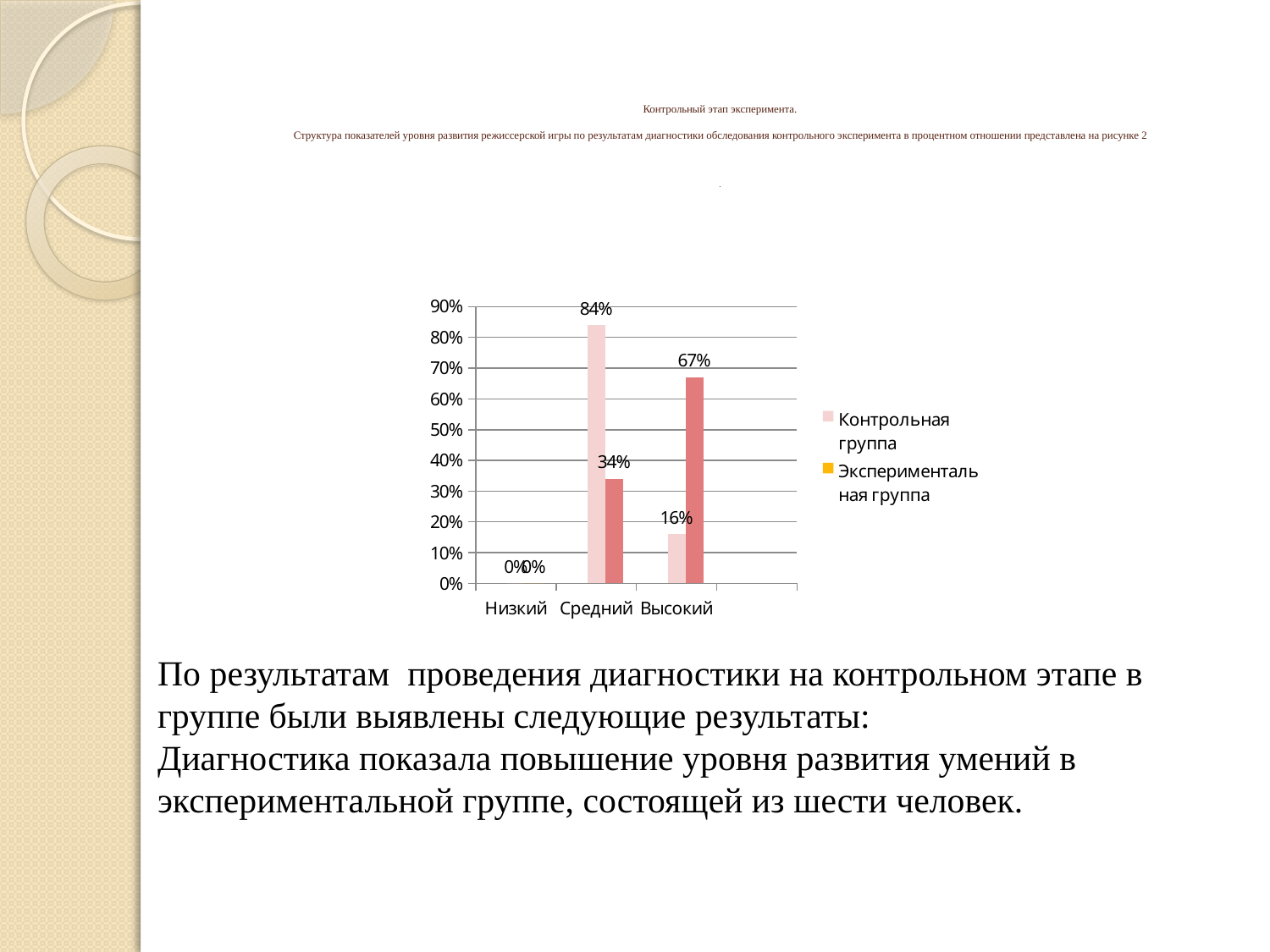
In which category does the Экспериментальная группа series have its highest value? Высокий What is the value for the Экспериментальная группа series in the Высокий category? 67% What is the value for the Экспериментальная группа series in the Средний category? 34% What is the value for the Контрольная группа series in the Высокий category? 16% What is the value for the Контрольная группа series in the Низкий category? 0% In which category does the Контрольная группа series have its highest value? Средний In the Высокий category, which series has the larger value: Контрольная группа or Экспериментальная группа? Экспериментальная группа What is the difference between the Контрольная группа and Экспериментальная группа values in the Средний category? 50% How many series does the chart legend list? 2 How many categories are shown on the x axis of the chart? 3 What is the value for the Контрольная группа series in the Средний category? 84% What kind of chart is shown on the slide? Bar chart